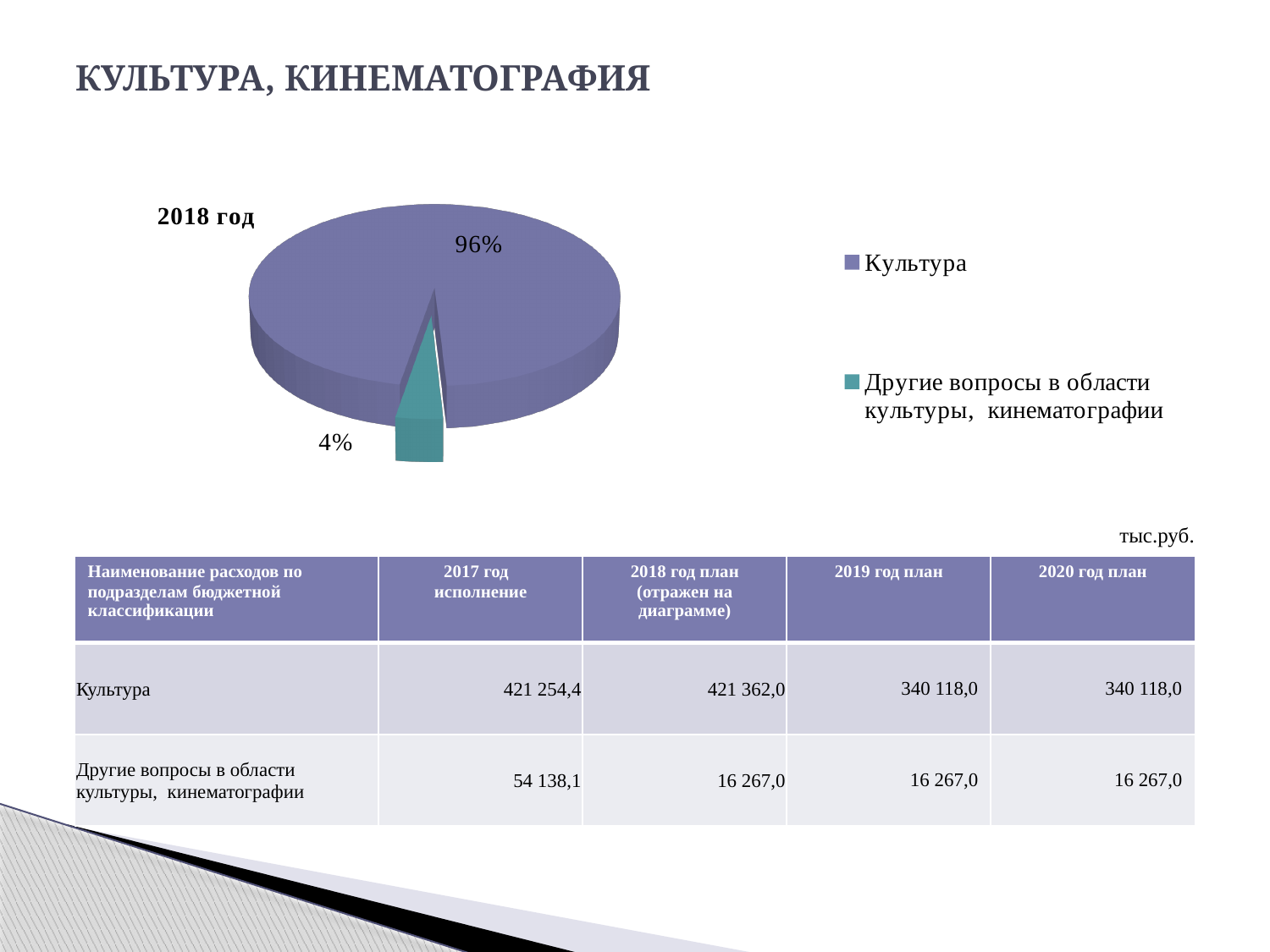
What share of the pie does Другие вопросы в области культуры, кинематографии have? 4% Which legend entry is shown in teal (green) colour? Другие вопросы в области культуры, кинематографии How many entries does the legend list? 2 What is the title of the pie chart? 2018 год What share of the pie does Культура have? 96% Which slice of the pie is the largest? Культура Which slice of the pie is the smallest? Другие вопросы в области культуры, кинематографии Which is larger: the share for Культура or the share for Другие вопросы в области культуры, кинематографии? Культура What is the difference in percentage points between the Культура slice and the Другие вопросы в области культуры, кинематографии slice? 92 How many slices does the pie chart have? 2 What kind of chart is shown on the slide? pie chart